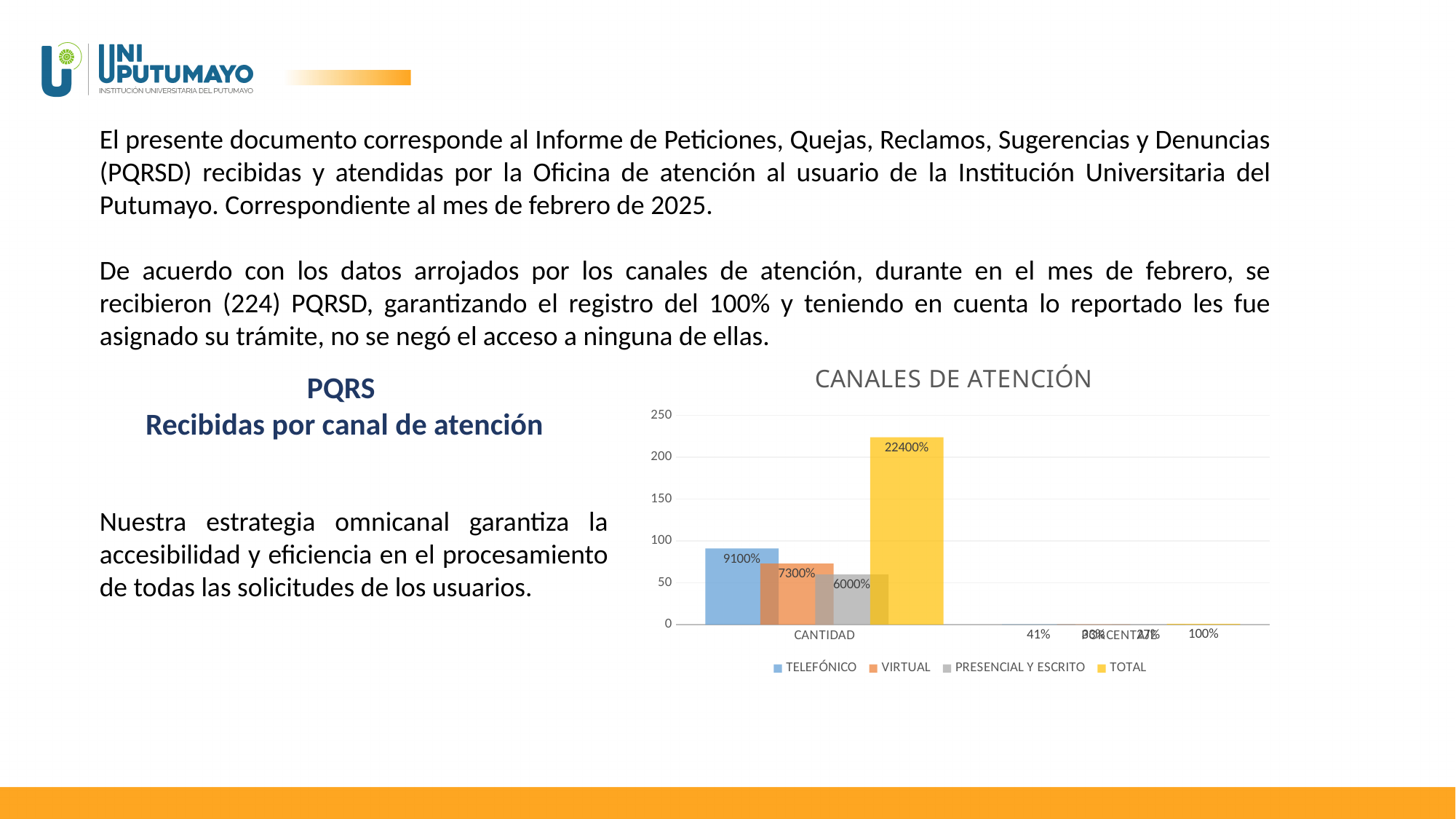
In the "CANALES DE ATENCIÓN" chart, is the TOTAL bar for CANTIDAD greater or less than 200? greater Which series are listed in the legend of the "CANALES DE ATENCIÓN" chart? TELEFÓNICO, VIRTUAL, PRESENCIAL Y ESCRITO, TOTAL In the "CANALES DE ATENCIÓN" chart, which series has the tallest bar for CANTIDAD? TOTAL In the "CANALES DE ATENCIÓN" chart, what data label is shown on the PRESENCIAL Y ESCRITO bar for CANTIDAD? 6000% What is the title of the chart on the slide? CANALES DE ATENCIÓN In the "CANALES DE ATENCIÓN" chart, what data label is shown on the VIRTUAL bar for CANTIDAD? 7300% How many series does the legend of the "CANALES DE ATENCIÓN" chart list? 4 What type of chart is shown under the title "CANALES DE ATENCIÓN"? bar chart In the "CANALES DE ATENCIÓN" chart, which CANTIDAD bar is taller, TELEFÓNICO or VIRTUAL? TELEFÓNICO In the "CANALES DE ATENCIÓN" chart, what data label is shown on the TELEFÓNICO bar for CANTIDAD? 9100% In the "CANALES DE ATENCIÓN" chart, which series has the shortest bar for CANTIDAD? PRESENCIAL Y ESCRITO In the "CANALES DE ATENCIÓN" chart, what data label is shown on the TOTAL bar for CANTIDAD? 22400%